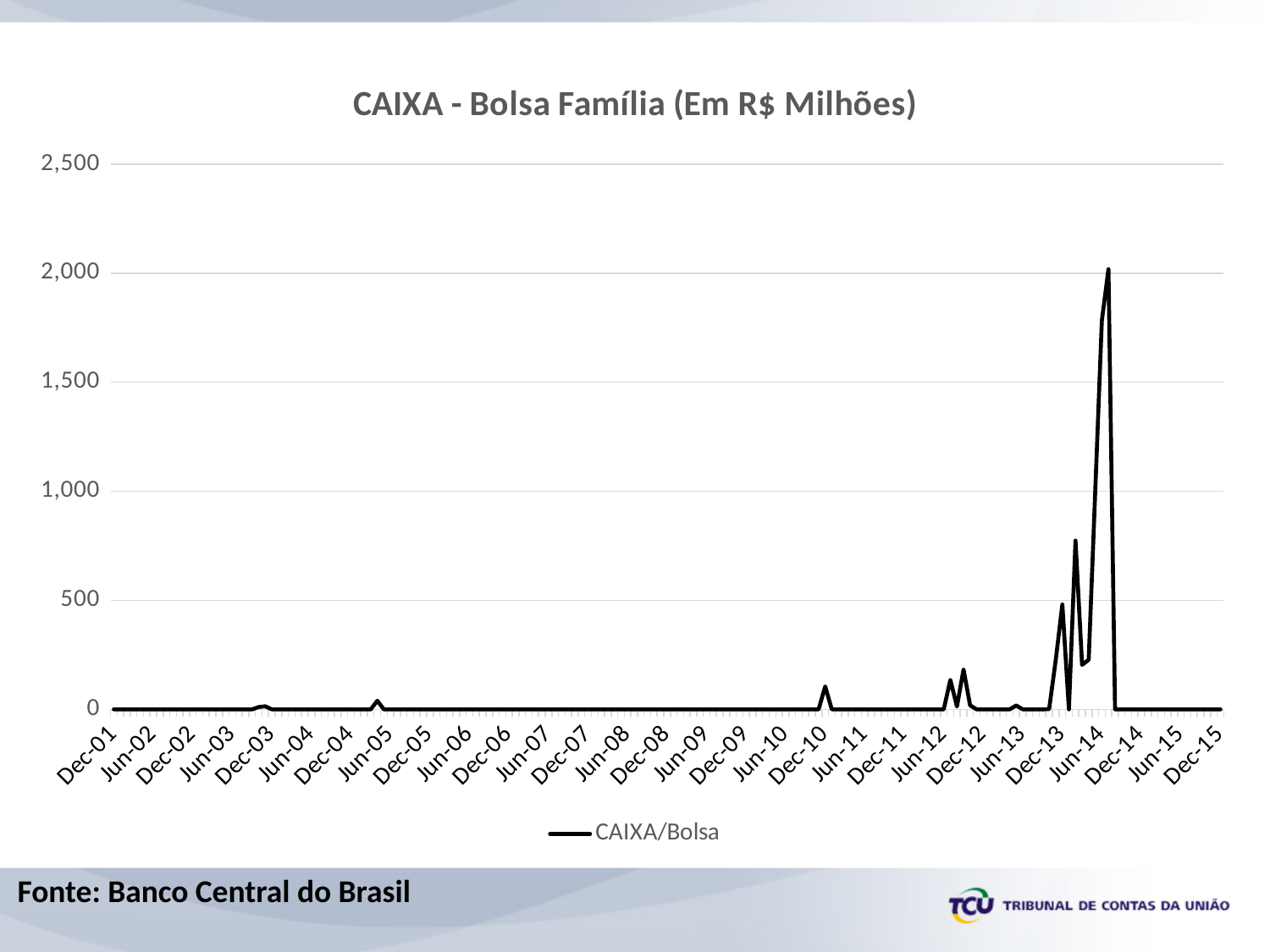
In which year does the CAIXA/Bolsa series reach its highest value? 2014 What kind of chart is shown on the slide? line chart Is the highest value of the CAIXA/Bolsa series greater or less than 1,500? greater Is the value for Dec-05 greater or less than 500? less Is the value for Dec-10 greater or less than 500? less What is the title of the chart? CAIXA - Bolsa Família (Em R$ Milhões) Which is larger, the spike near Dec-10 or the peak in 2014? the peak in 2014 What is the first date label on the x axis? Dec-01 What is the name of the series shown in the legend? CAIXA/Bolsa How many date labels are shown along the x axis? 29 How many series does the legend list? 1